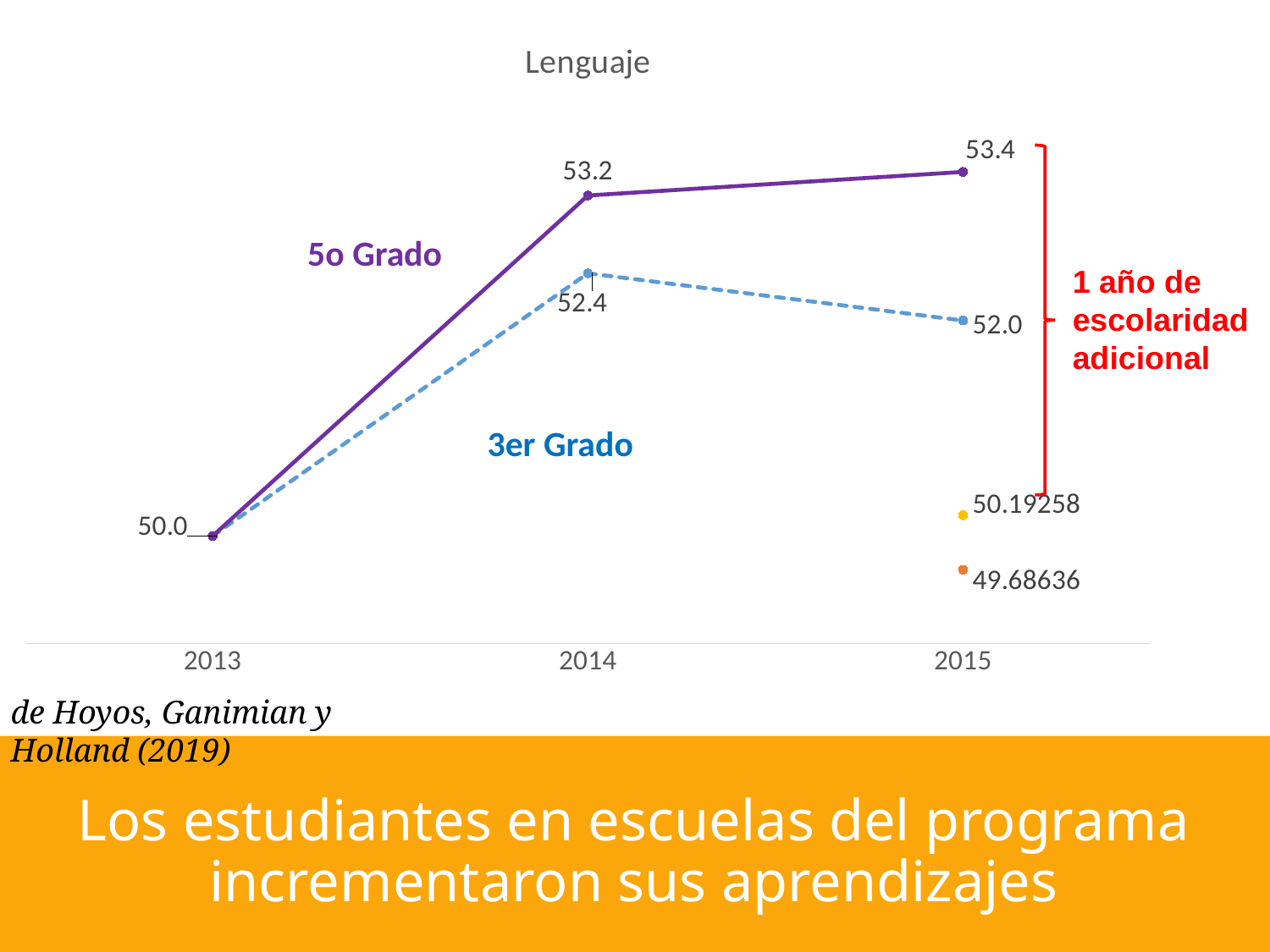
What kind of chart is shown on the slide? line chart What is the value for 5o Grado in 2015? 53.4 How many years are shown on the x axis? 3 Which is larger in 2014, the 5o Grado value or the 3er Grado value? 5o Grado What is the value shown for 2013? 50.0 In which year is the 5o Grado value highest? 2015 What is the difference between the 5o Grado and 3er Grado values in 2015? 1.4 What is the title of the chart? Lenguaje What is the value for 5o Grado in 2014? 53.2 What is the value for 3er Grado in 2015? 52.0 In which year is the 3er Grado value highest? 2014 What is the value for 3er Grado in 2014? 52.4